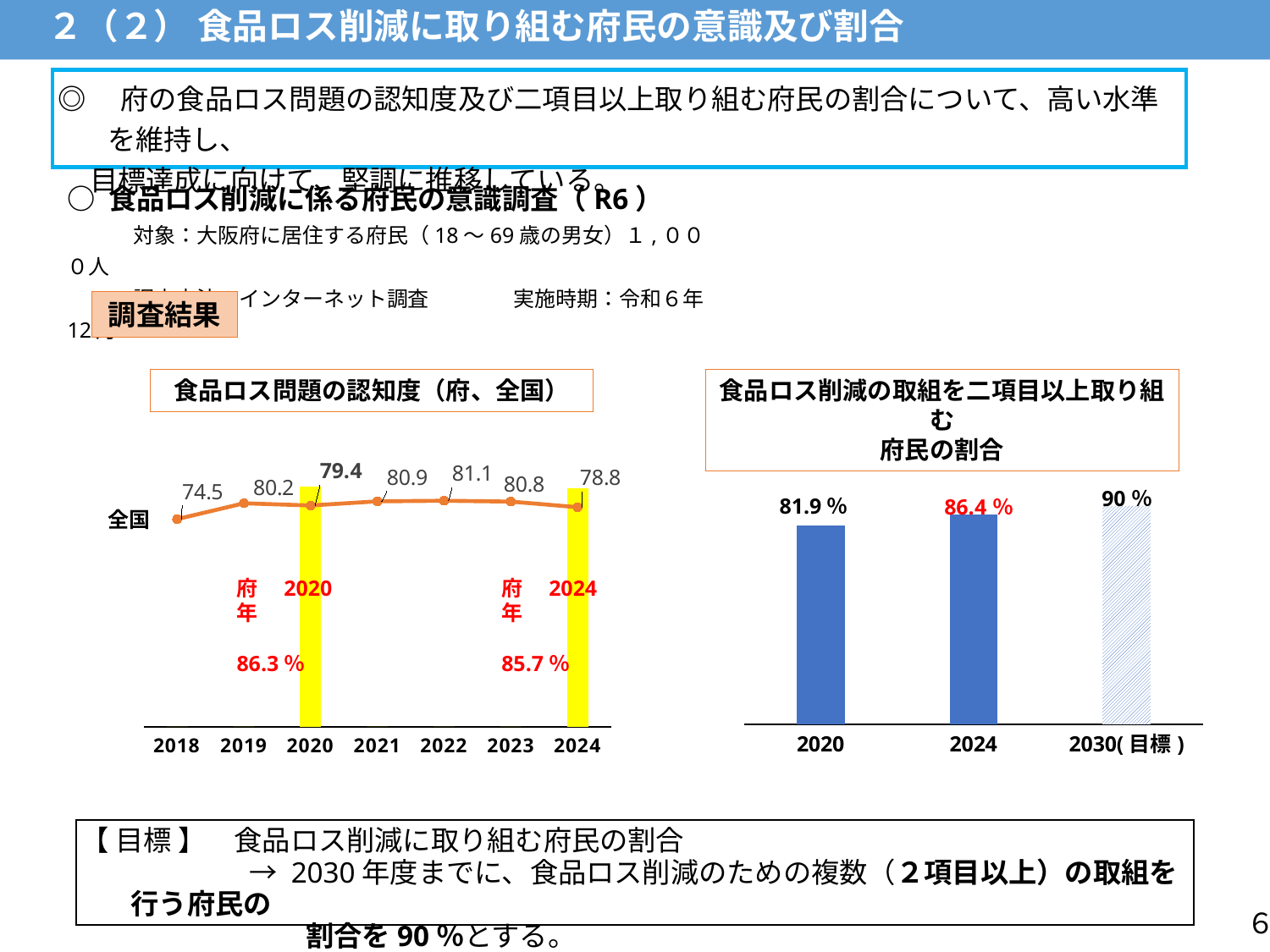
In the right chart (食品ロス削減の取組を二項目以上取り組む府民の割合), what is the value for 2020? 81.9% In the left chart (食品ロス問題の認知度), how many years are shown on the x axis? 7 In the right chart (食品ロス削減の取組を二項目以上取り組む府民の割合), what is the value for 2030(目標)? 90% In the left chart (食品ロス問題の認知度), what is the 府 value for 2024年? 85.7% In the left chart (食品ロス問題の認知度), what is the 府 value for 2020年? 86.3% In the left chart (食品ロス問題の認知度), what is the 全国 value for 2018? 74.5 In the left chart (食品ロス問題の認知度), which year has the highest 全国 value? 2022 In the left chart (食品ロス問題の認知度), what is the difference between the 全国 values for 2019 and 2018? 5.7 In the left chart (食品ロス問題の認知度), what is the 全国 value for 2022? 81.1 What kind of chart is the right chart (食品ロス削減の取組を二項目以上取り組む府民の割合)? bar chart In the right chart (食品ロス削減の取組を二項目以上取り組む府民の割合), what is the difference between the 2024 and 2020 values? 4.5% In the left chart (食品ロス問題の認知度), which year has the lowest 全国 value? 2018